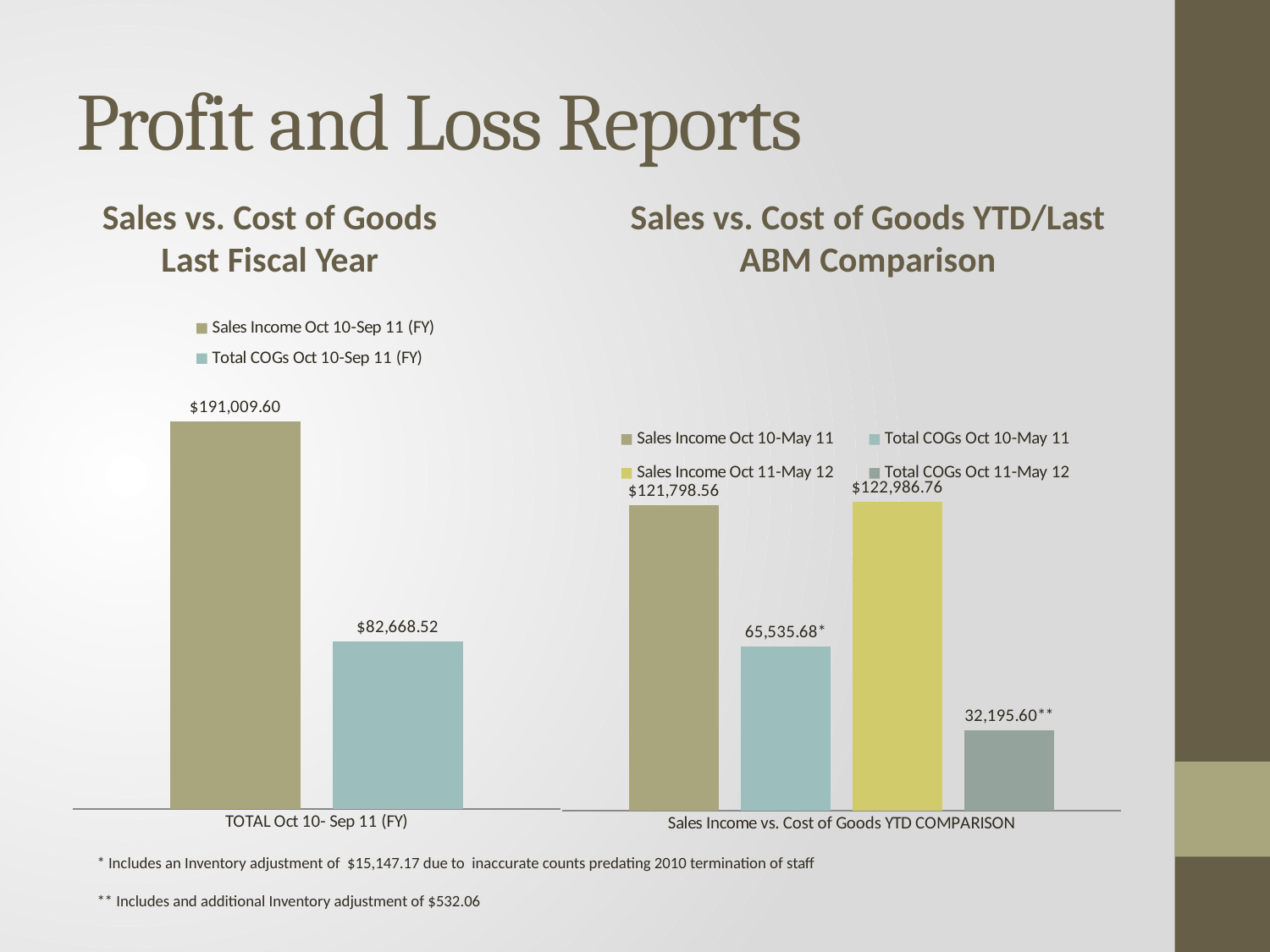
In the 'Sales vs. Cost of Goods YTD/Last ABM Comparison' chart, which series has the lowest value? Total COGs Oct 11-May 12 In the 'Sales vs. Cost of Goods YTD/Last ABM Comparison' chart, what is the value for Total COGs Oct 10-May 11? 65,535.68 In the 'Sales vs. Cost of Goods YTD/Last ABM Comparison' chart, what is the value for Total COGs Oct 11-May 12? 32,195.60 In the 'Sales vs. Cost of Goods YTD/Last ABM Comparison' chart, what is the value for Sales Income Oct 10-May 11? $121,798.56 What kind of chart is the 'Sales vs. Cost of Goods Last Fiscal Year' chart? Bar chart In the 'Sales vs. Cost of Goods YTD/Last ABM Comparison' chart, which is larger: Sales Income Oct 11-May 12 or Sales Income Oct 10-May 11? Sales Income Oct 11-May 12 How many series does the legend of the 'Sales vs. Cost of Goods YTD/Last ABM Comparison' chart list? 4 In the 'Sales vs. Cost of Goods Last Fiscal Year' chart, what is the difference between Sales Income and Total COGs? $108,341.08 In the 'Sales vs. Cost of Goods YTD/Last ABM Comparison' chart, what is the difference between Total COGs Oct 10-May 11 and Total COGs Oct 11-May 12? 33,340.08 How many series does the legend of the 'Sales vs. Cost of Goods Last Fiscal Year' chart list? 2 In the 'Sales vs. Cost of Goods Last Fiscal Year' chart, what is the value for Total COGs Oct 10-Sep 11 (FY)? $82,668.52 In the 'Sales vs. Cost of Goods Last Fiscal Year' chart, what is the value for Sales Income Oct 10-Sep 11 (FY)? $191,009.60